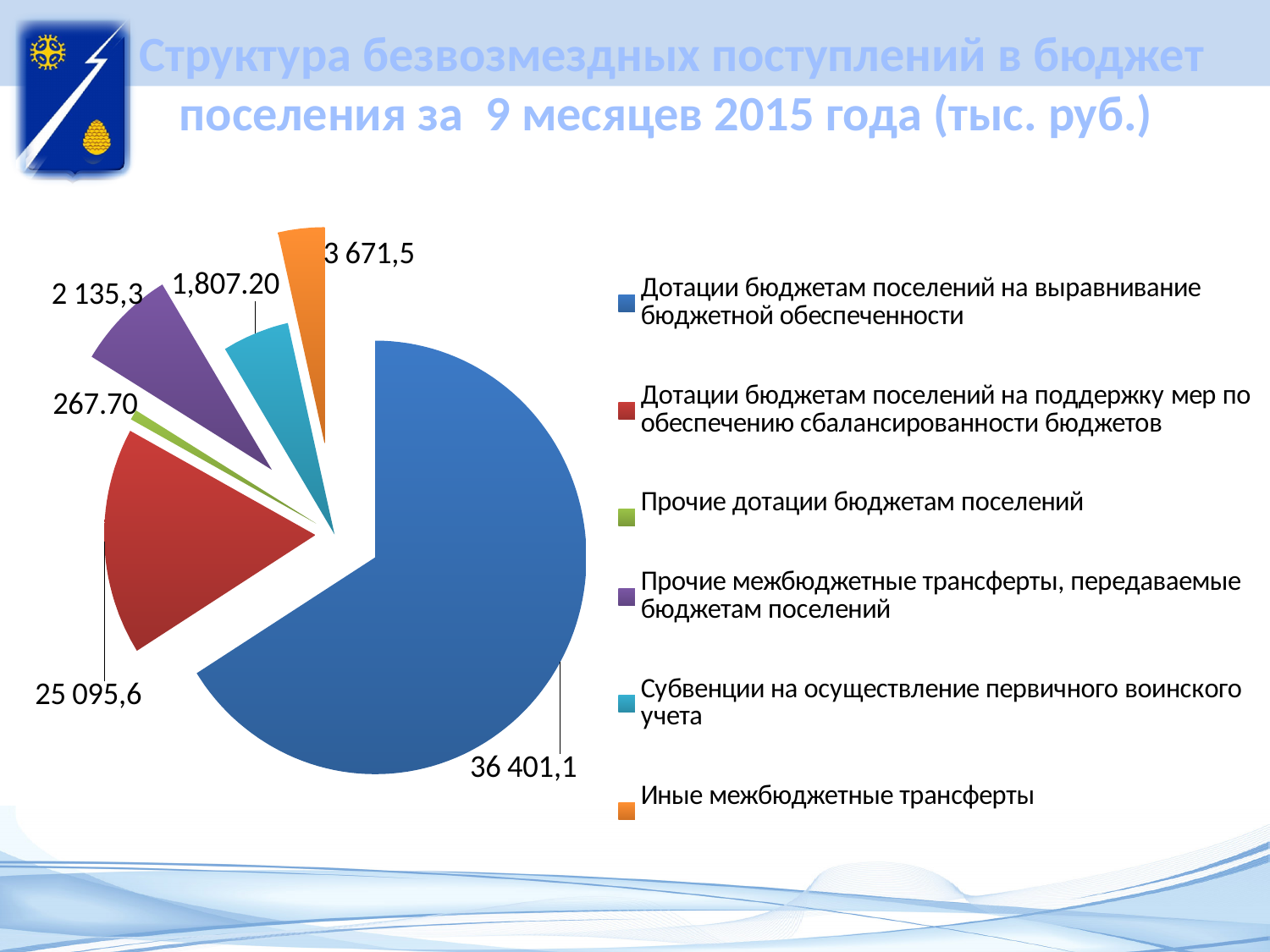
What type of chart is shown on the slide? pie chart What is the value for 'Дотации бюджетам поселений на поддержку мер по обеспечению сбалансированности бюджетов'? 25 095,6 What is the value for 'Дотации бюджетам поселений на выравнивание бюджетной обеспеченности'? 36 401,1 How many slices does the pie chart have? 6 Which category has the largest slice of the pie? Дотации бюджетам поселений на выравнивание бюджетной обеспеченности What is the value for 'Субвенции на осуществление первичного воинского учета'? 1,807.20 How many entries does the legend list? 6 What is the value for 'Иные межбюджетные трансферты'? 3 671,5 What is the difference between the values for 'Дотации бюджетам поселений на выравнивание бюджетной обеспеченности' and 'Дотации бюджетам поселений на поддержку мер по обеспечению сбалансированности бюджетов'? 11 305,5 Which category has the smallest slice of the pie? Прочие дотации бюджетам поселений What is the value for 'Прочие дотации бюджетам поселений'? 267.70